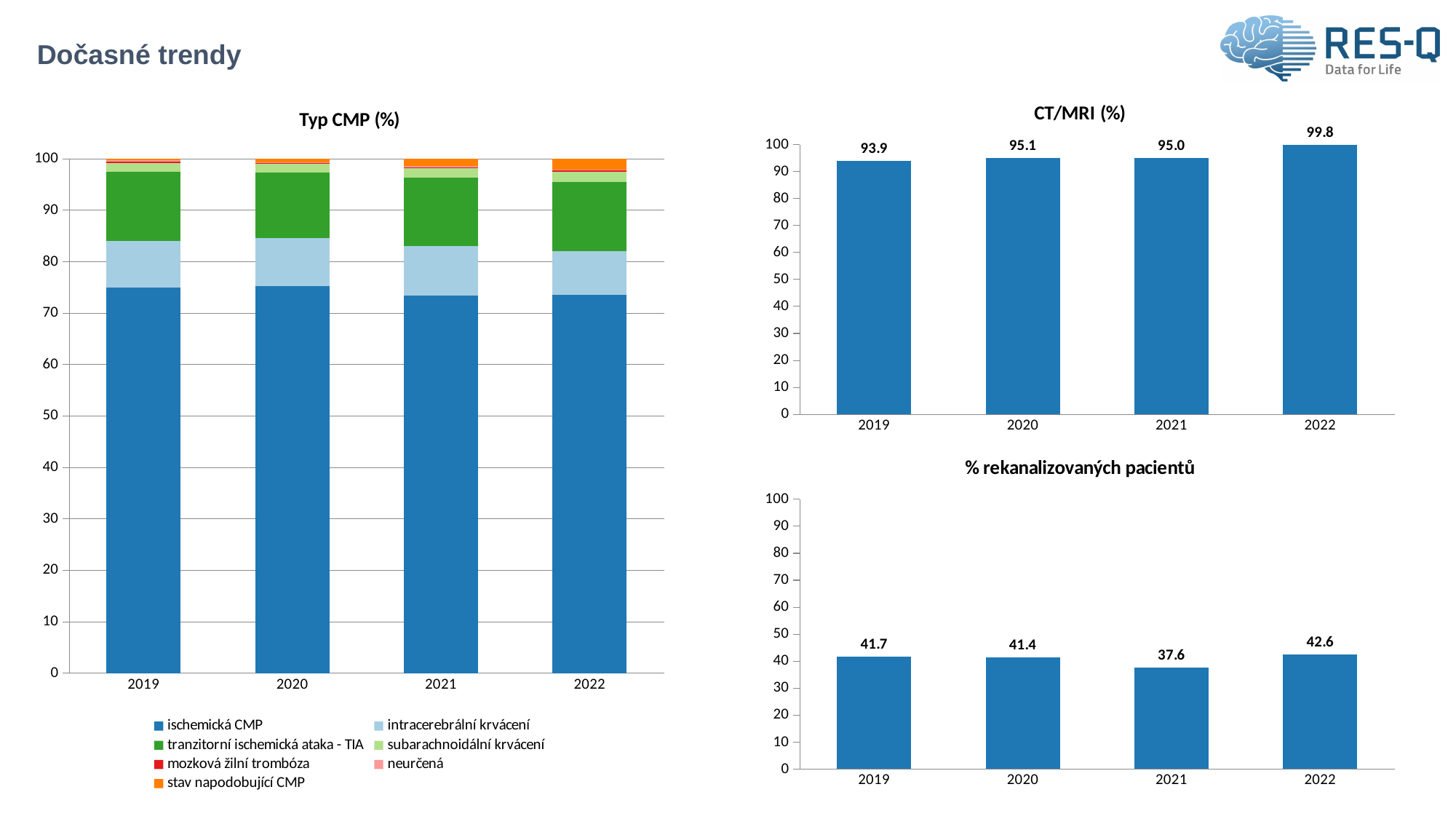
In the % rekanalizovaných pacientů chart, what is the difference between the 2022 and 2021 values? 5.0 In the CT/MRI (%) chart, what is the difference between the 2022 and 2019 values? 5.9 In the CT/MRI (%) chart, what is the value for 2022? 99.8 In the % rekanalizovaných pacientů chart, what is the value for 2021? 37.6 In the % rekanalizovaných pacientů chart, which year has the lowest value? 2021 In the CT/MRI (%) chart, which year has the highest value? 2022 In the Typ CMP (%) chart, how many series does the legend list? 7 In the % rekanalizovaných pacientů chart, which is larger, the value for 2019 or the value for 2020? 2019 What kind of chart is the Typ CMP (%) chart? stacked bar chart In the Typ CMP (%) chart, is the value for ischemická CMP in 2019 greater or less than 70? greater In the CT/MRI (%) chart, what is the value for 2019? 93.9 In the CT/MRI (%) chart, which year has the lowest value? 2019